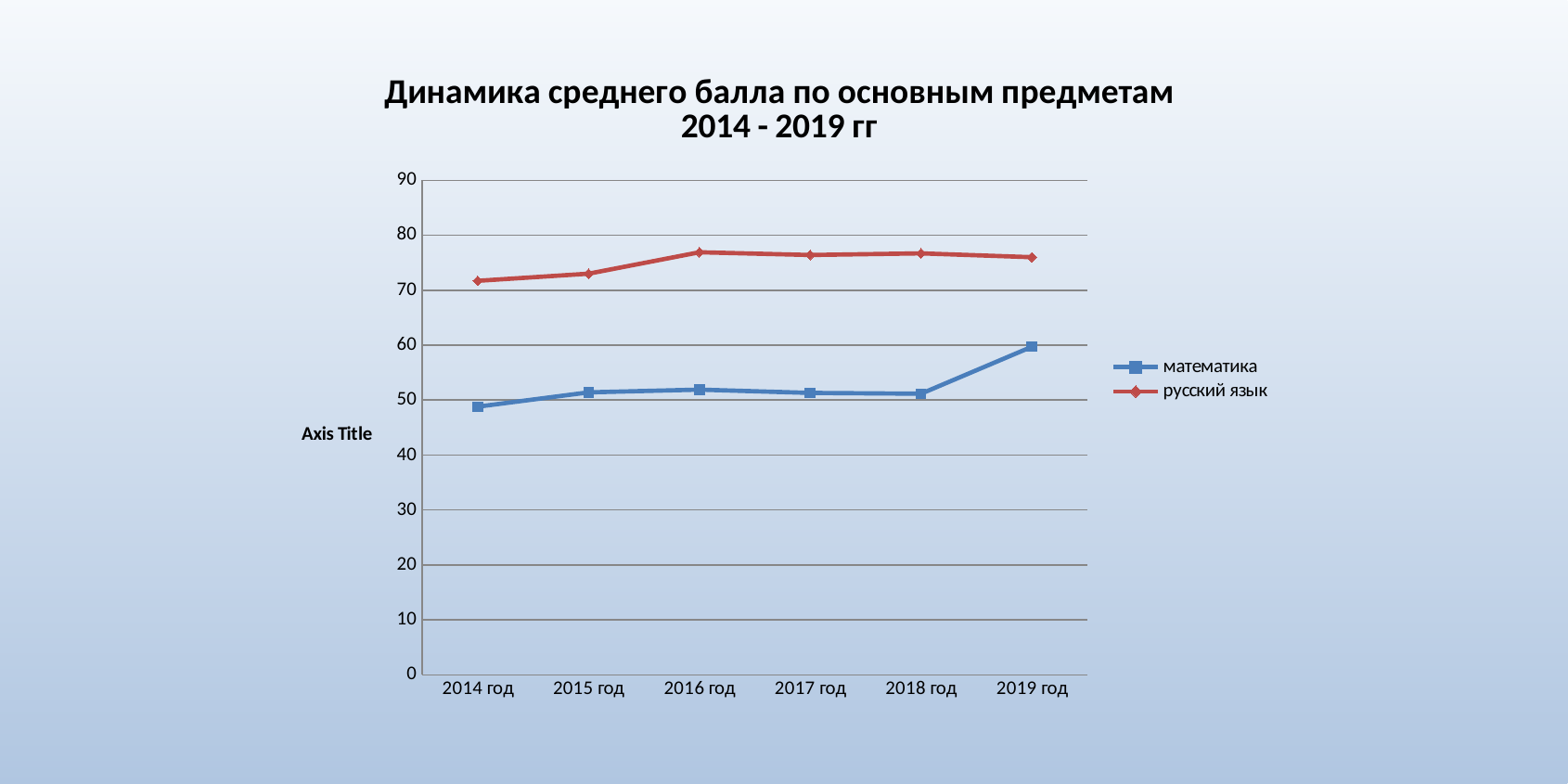
Is the value for русский язык in 2014 год greater or less than 70? greater What kind of chart is shown on the slide? line chart In which year is the value for русский язык lowest? 2014 год Which series is shown in red in the legend? русский язык Does the value for математика rise or fall from 2018 год to 2019 год? rise What is the title of the chart? Динамика среднего балла по основным предметам 2014 - 2019 гг Which series has the larger value in 2019 год, математика or русский язык? русский язык Is the value for математика in 2014 год greater or less than 50? less How many years are shown on the x axis? 6 In which year is the value for математика highest? 2019 год How many series does the legend list? 2 In which year is the value for математика lowest? 2014 год